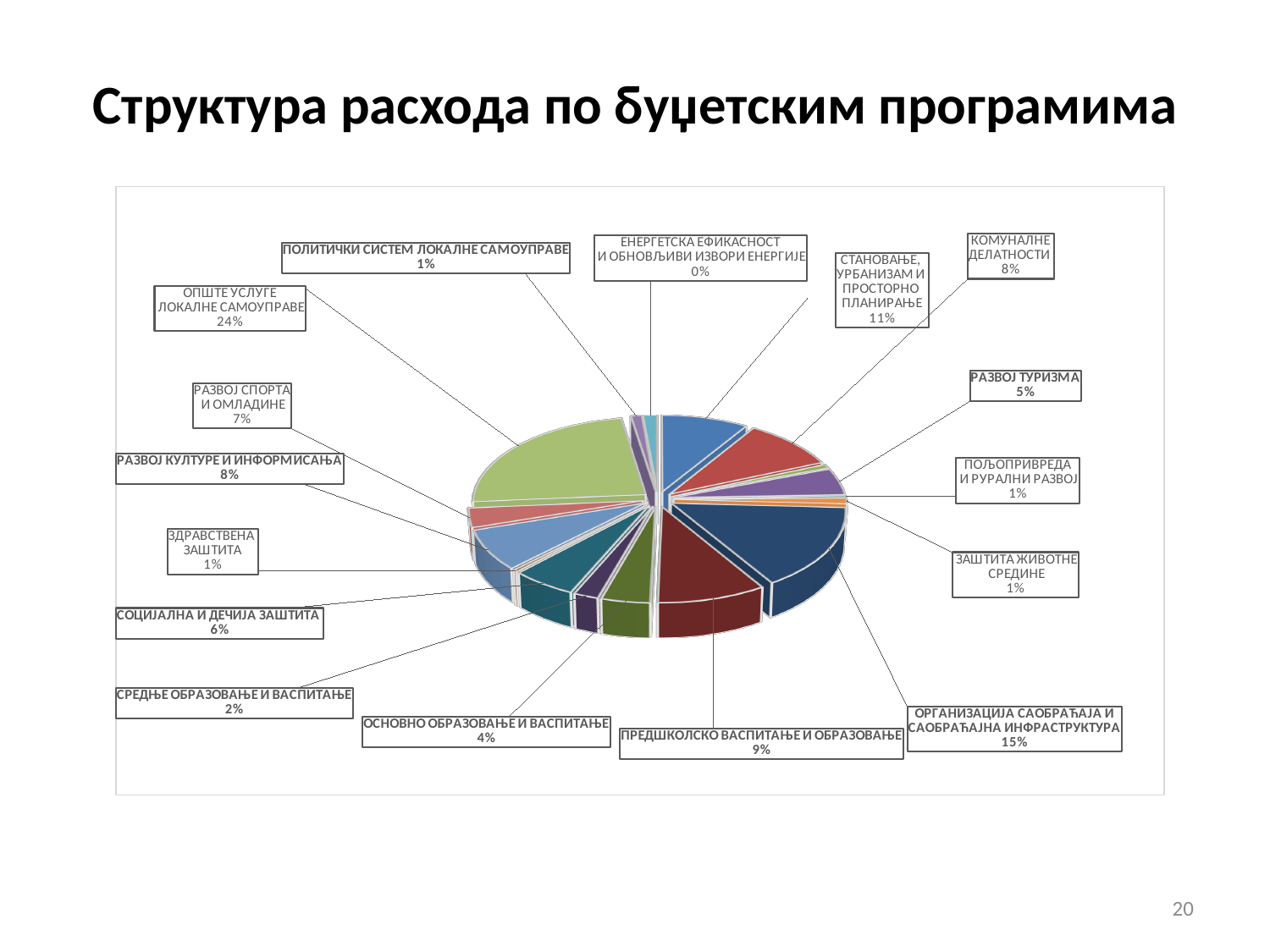
Which program has the smallest share of the pie? ЕНЕРГЕТСКА ЕФИКАСНОСТ И ОБНОВЉИВИ ИЗВОРИ ЕНЕРГИЈЕ How many budget programs (slices) are labelled on the pie chart? 16 What percentage is shown for СОЦИЈАЛНА И ДЕЧИЈА ЗАШТИТА? 6% What kind of chart is shown on the slide? Pie chart What share of the pie does ОПШТЕ УСЛУГЕ ЛОКАЛНЕ САМОУПРАВЕ have? 24% Which has a larger share: КОМУНАЛНЕ ДЕЛАТНОСТИ or РАЗВОЈ ТУРИЗМА? КОМУНАЛНЕ ДЕЛАТНОСТИ What is the title of the chart on the slide? Структура расхода по буџетским програмима What percentage is shown for ОРГАНИЗАЦИЈА САОБРАЋАЈА И САОБРАЋАЈНА ИНФРАСТРУКТУРА? 15% What percentage is shown for ПРЕДШКОЛСКО ВАСПИТАЊЕ И ОБРАЗОВАЊЕ? 9% What is the difference in percentage points between ОПШТЕ УСЛУГЕ ЛОКАЛНЕ САМОУПРАВЕ and ОРГАНИЗАЦИЈА САОБРАЋАЈА И САОБРАЋАЈНА ИНФРАСТРУКТУРА? 9 percentage points What percentage is shown for СТАНОВАЊЕ, УРБАНИЗАМ И ПРОСТОРНО ПЛАНИРАЊЕ? 11% Which program has the largest share of the pie? ОПШТЕ УСЛУГЕ ЛОКАЛНЕ САМОУПРАВЕ